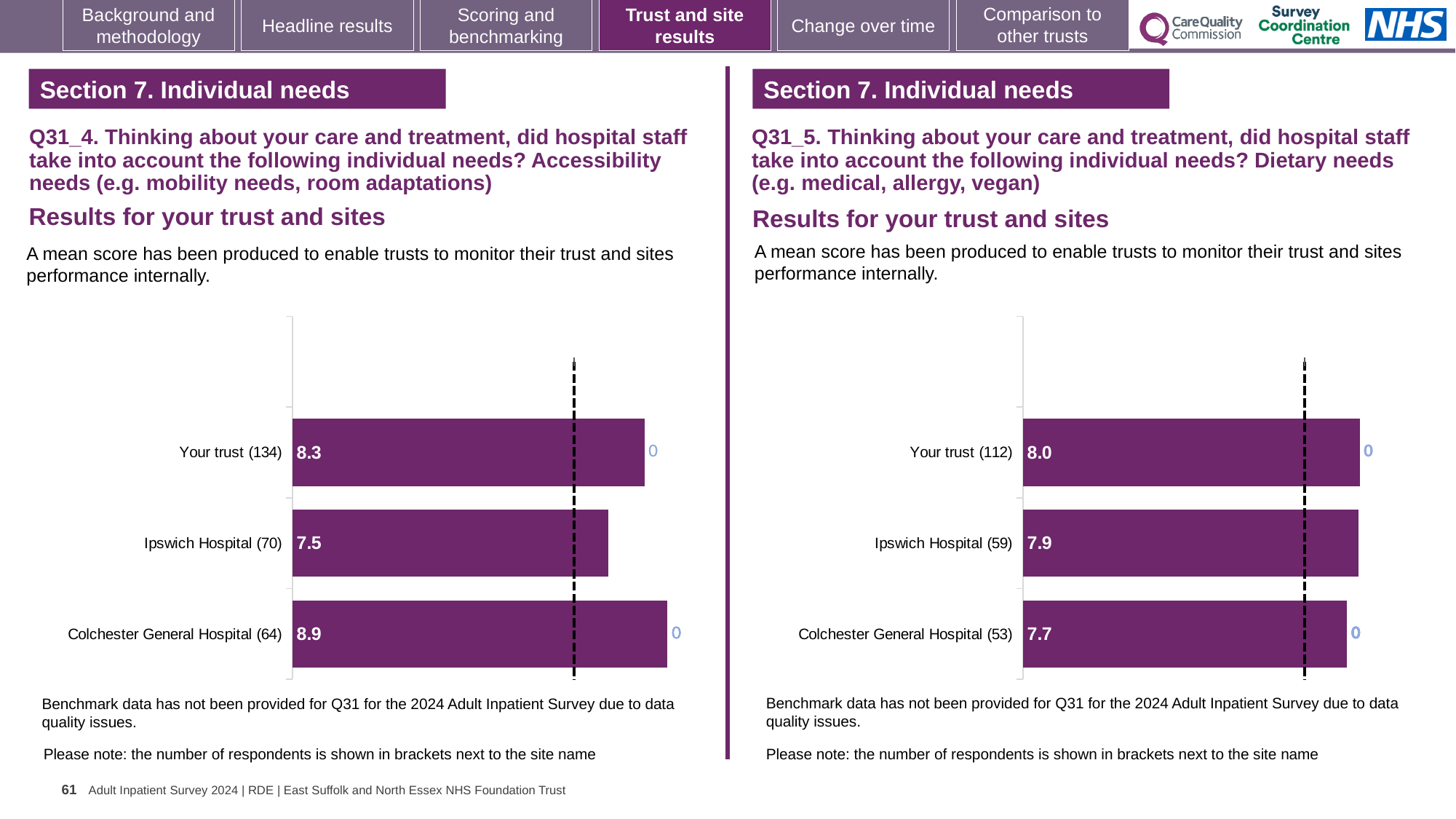
In the right chart (Q31_5, dietary needs), what is the mean score for Colchester General Hospital? 7.7 In the left chart (Q31_4, accessibility needs), what is the mean score for Your trust? 8.3 In the left chart (Q31_4, accessibility needs), which has the larger mean score: Your trust or Ipswich Hospital? Your trust How many bars are plotted in the right chart (Q31_5, dietary needs)? 3 In the left chart (Q31_4, accessibility needs), what is the difference between the Colchester General Hospital score and the Ipswich Hospital score? 1.4 In the left chart (Q31_4, accessibility needs), which site or trust has the highest mean score? Colchester General Hospital In the left chart (Q31_4, accessibility needs), what is the mean score for Ipswich Hospital? 7.5 What type of chart is used in the left chart (Q31_4, accessibility needs)? Bar chart In the right chart (Q31_5, dietary needs), how many respondents are shown in brackets for Ipswich Hospital? 59 In the right chart (Q31_5, dietary needs), what is the mean score for Your trust? 8.0 In the right chart (Q31_5, dietary needs), what is the difference between the Your trust score and the Ipswich Hospital score? 0.1 In the right chart (Q31_5, dietary needs), which site or trust has the lowest mean score? Colchester General Hospital